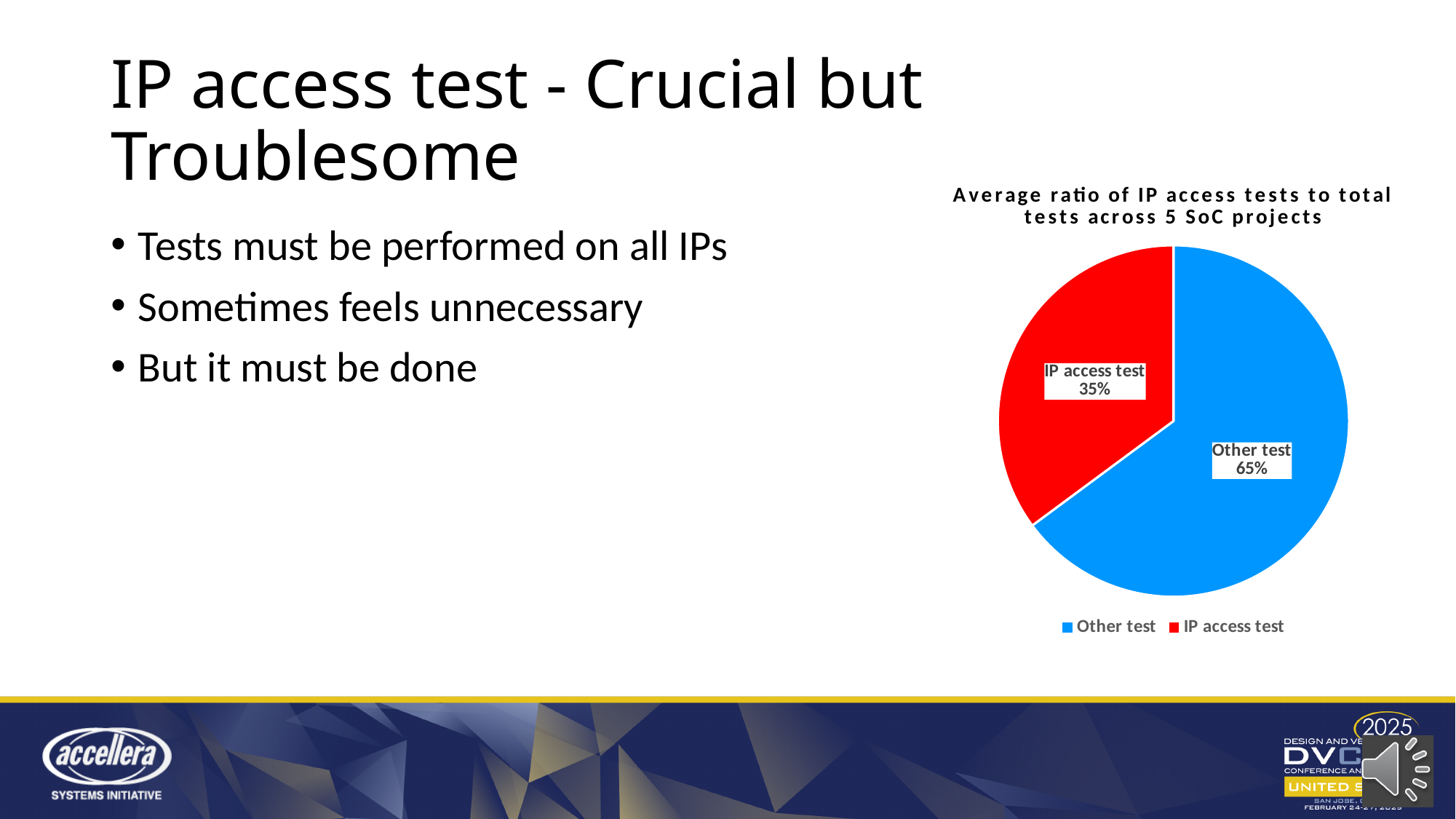
What is the value for Other test in the pie chart? 65% What is the difference between the Other test share and the IP access test share? 30% How many slices does the pie chart have? 2 What is the value for IP access test in the pie chart? 35% What colour is the IP access test slice in the pie chart? red What share of the pie does the IP access test slice represent? 35% Which slice of the pie chart is the smallest? IP access test How many entries does the legend list? 2 Which slice of the pie chart is the largest? Other test What kind of chart is shown on the slide? pie chart Which is larger, the IP access test slice or the Other test slice? Other test What is the title of the pie chart? Average ratio of IP access tests to total tests across 5 SoC projects